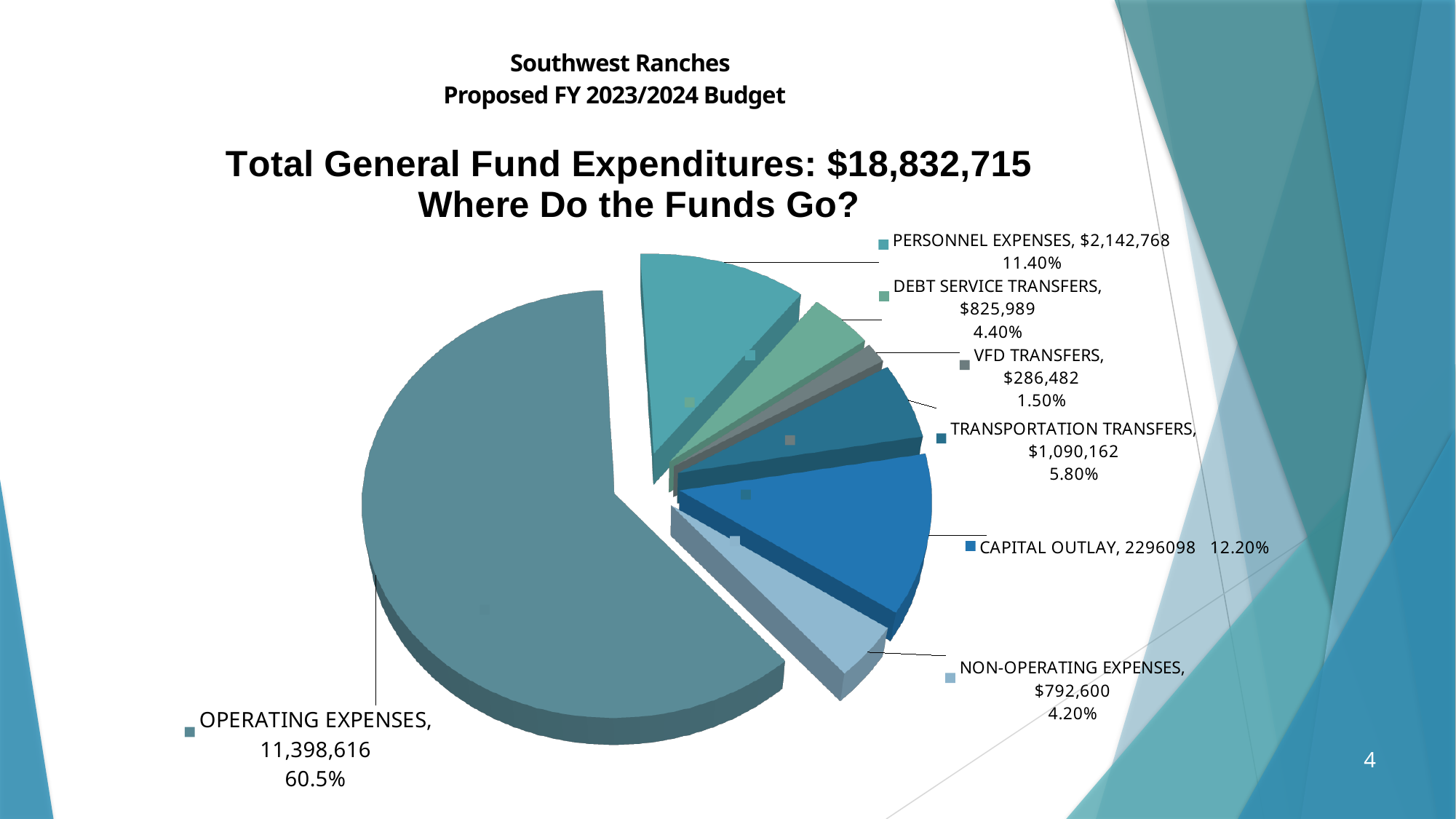
How many slices does the pie chart have? 7 What percentage share is shown for CAPITAL OUTLAY? 12.20% What percentage share is shown for OPERATING EXPENSES? 60.5% What kind of chart is shown on the slide? pie chart What is the value shown for TRANSPORTATION TRANSFERS? $1,090,162 Which is larger, DEBT SERVICE TRANSFERS or NON-OPERATING EXPENSES? DEBT SERVICE TRANSFERS What total general fund expenditure amount is stated in the chart title? $18,832,715 Which category has the smallest slice of the pie? VFD TRANSFERS Which category has the largest slice of the pie? OPERATING EXPENSES What is the difference between the percentage shares of CAPITAL OUTLAY and PERSONNEL EXPENSES? 0.80% What is the value shown for PERSONNEL EXPENSES? $2,142,768 What is the value shown for VFD TRANSFERS? $286,482